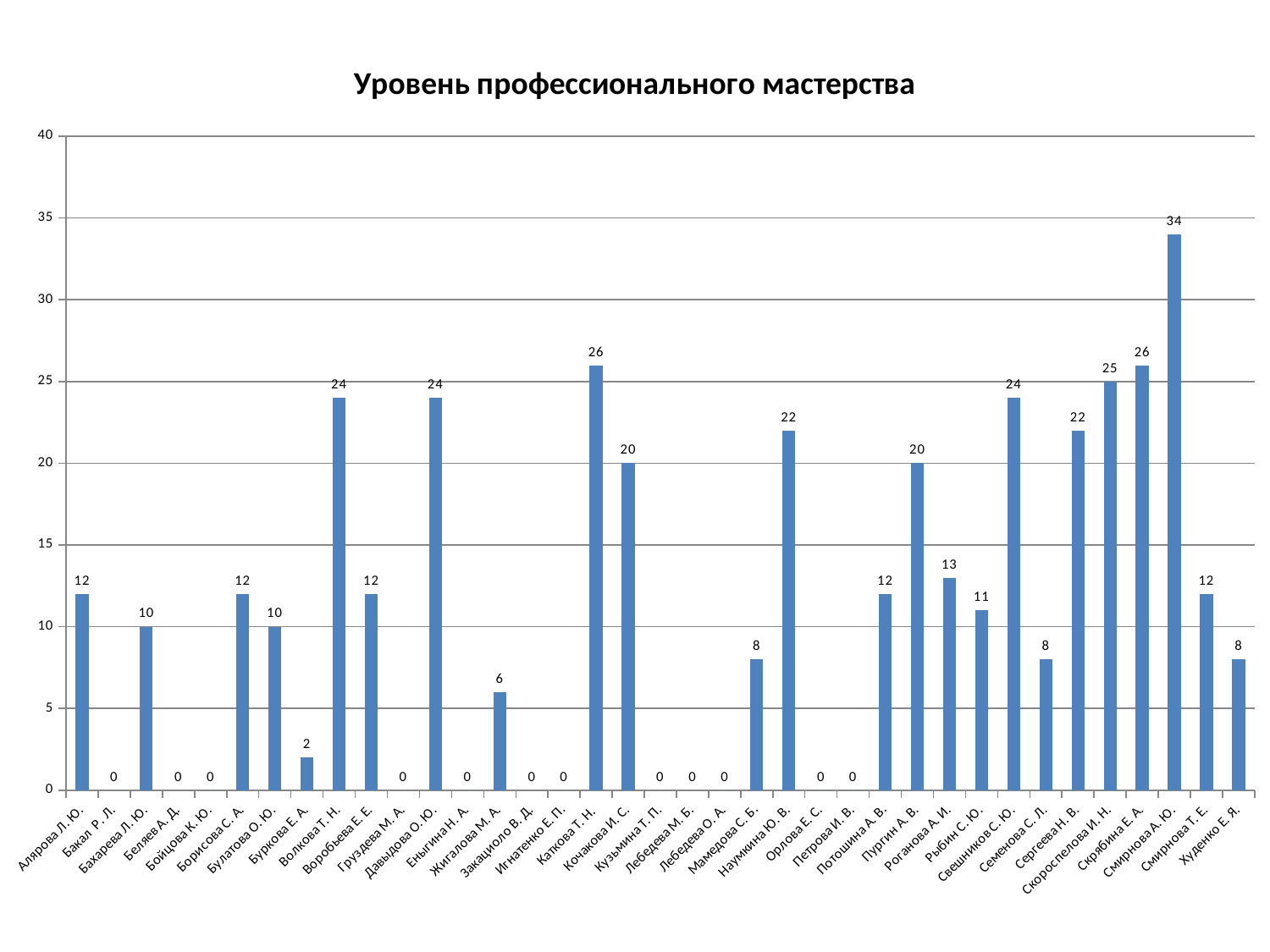
Which person has the highest value? Смирнова А. Ю. Which is larger, the value for Пургин А. В. or the value for Рыбин С. Ю.? Пургин А. В. What is the title of the chart? Уровень профессионального мастерства What is the value for Роганова А. И.? 13 What is the difference between the values for Смирнова А. Ю. and Каткова Т. Н.? 8 How many people are shown on the x axis? 37 Is the value for Волкова Т. Н. greater or less than 20? greater What kind of chart is this? bar chart What is the value for Жигалова М. А.? 6 What is the difference between the values for Наумкина Ю. В. and Мамедова С. Б.? 14 What is the value for Скороспелова И. Н.? 25 What is the value for Смирнова А. Ю.? 34